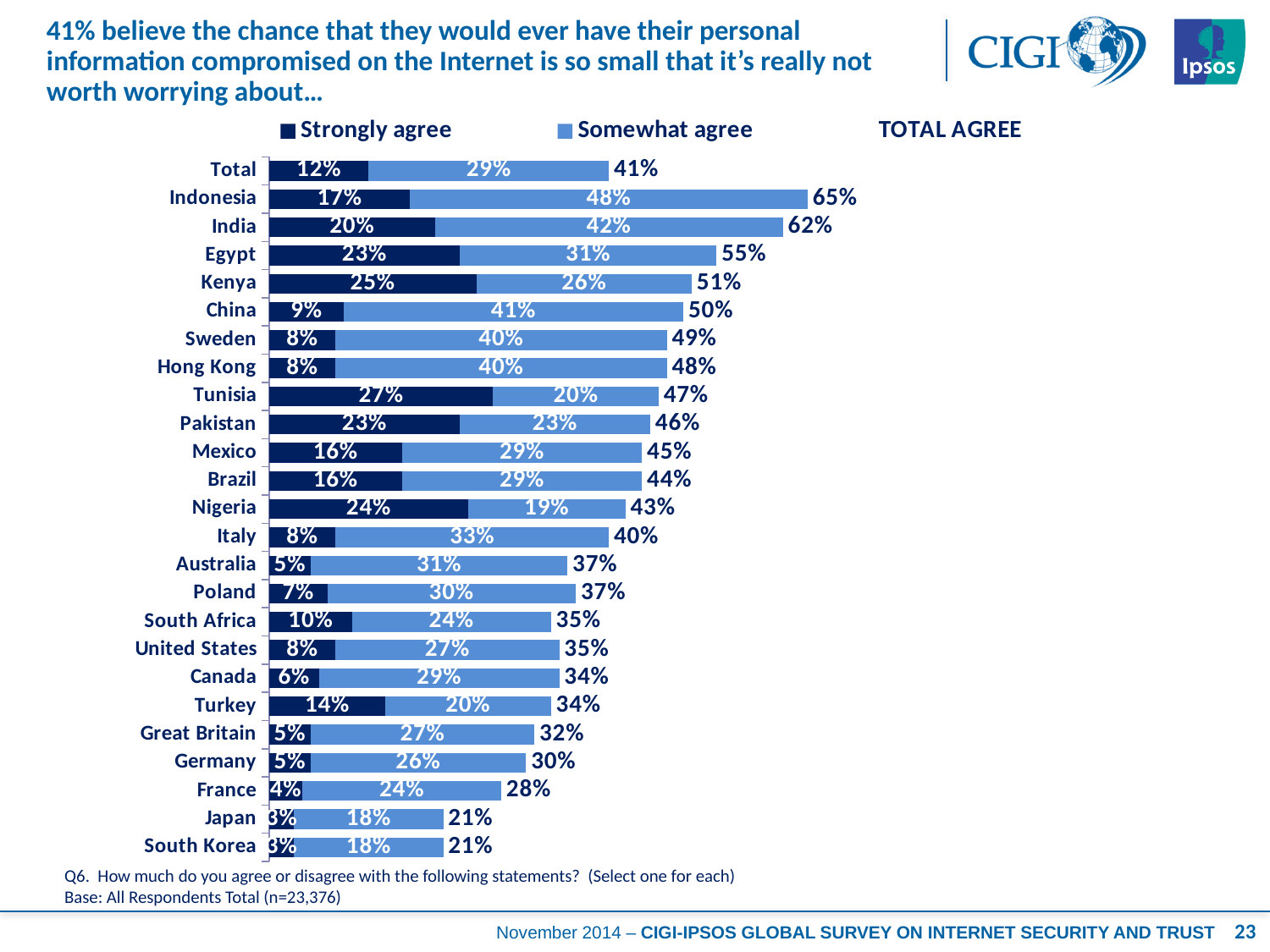
What is the 'Strongly agree' value for Indonesia? 17% How many series does the legend list? 2 Which has a larger 'Strongly agree' value, Kenya or Nigeria? Kenya Which country has the highest 'Strongly agree' value? Tunisia Which country has the highest TOTAL AGREE value? Indonesia What colour represents 'Strongly agree' in the chart? Dark navy blue What kind of chart is shown on the slide? Stacked bar chart What is the TOTAL AGREE value for Tunisia? 47% What is the difference between the TOTAL AGREE values for India and Egypt? 7 percentage points How many categories (rows) are shown in the chart? 25 Which country has the lowest 'Somewhat agree' value? Japan and South Korea (18%) What is the 'Somewhat agree' value for China? 41%